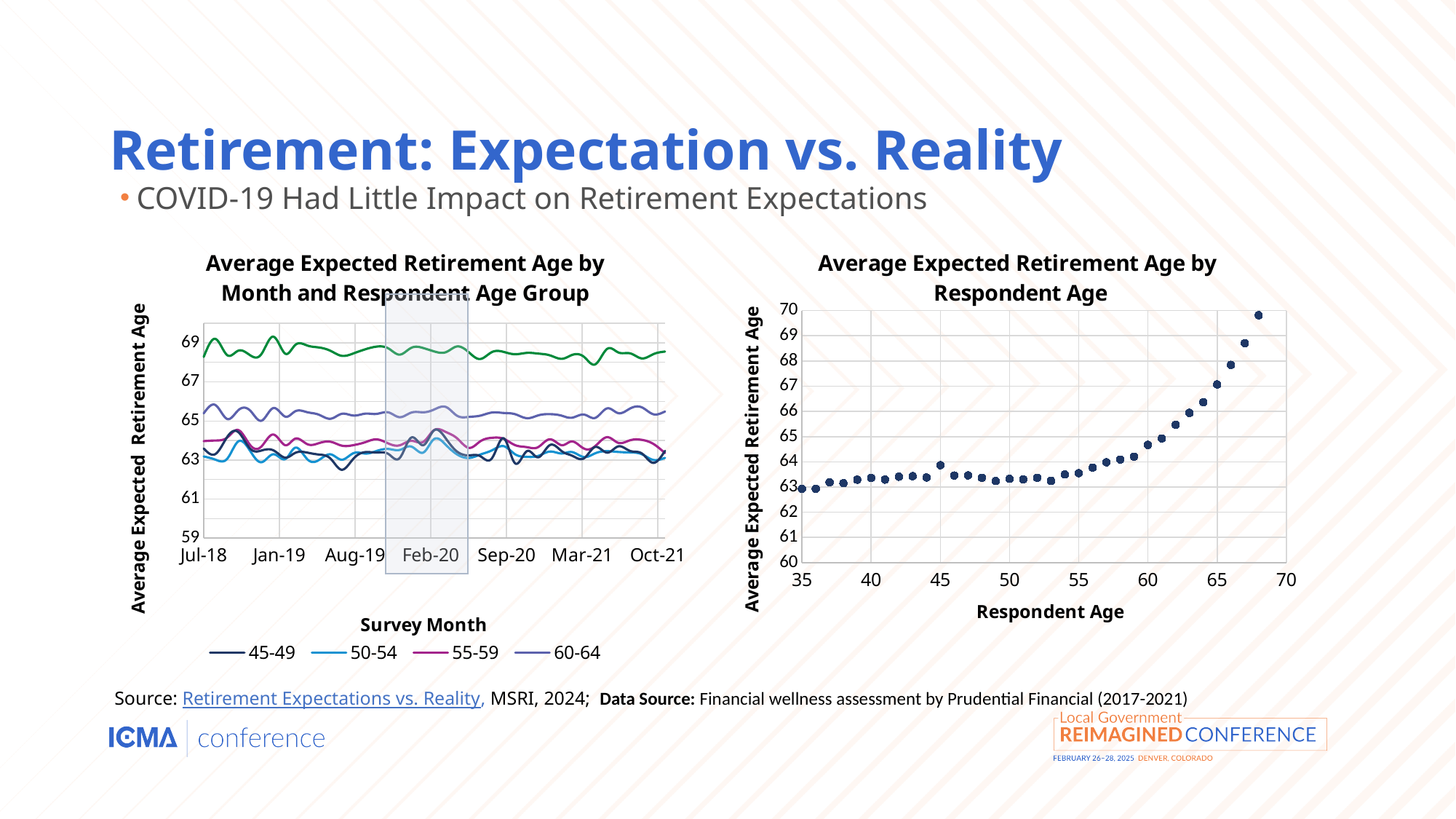
In the left chart, what is the title of the x axis? Survey Month What kind of chart is the right chart, 'Average Expected Retirement Age by Respondent Age'? scatter chart In the left chart, is the value for the 50-54 group in Oct-21 greater or less than 65? less In the right chart, is the value for respondent age 68 greater or less than 69? greater In the left chart, which survey month is highlighted with a shaded band? Feb-20 In the right chart, do the values rise or fall as respondent age increases from 55 to 68? rise In the left chart, which of the legend's age groups has the highest expected retirement age throughout the period? 60-64 In the left chart, is the value for the 60-64 group in Jul-18 greater or less than 63? greater What kind of chart is the left chart, 'Average Expected Retirement Age by Month and Respondent Age Group'? line chart In the left chart, how many series does the legend list? 4 In the right chart, at which respondent age is the expected retirement age highest? 68